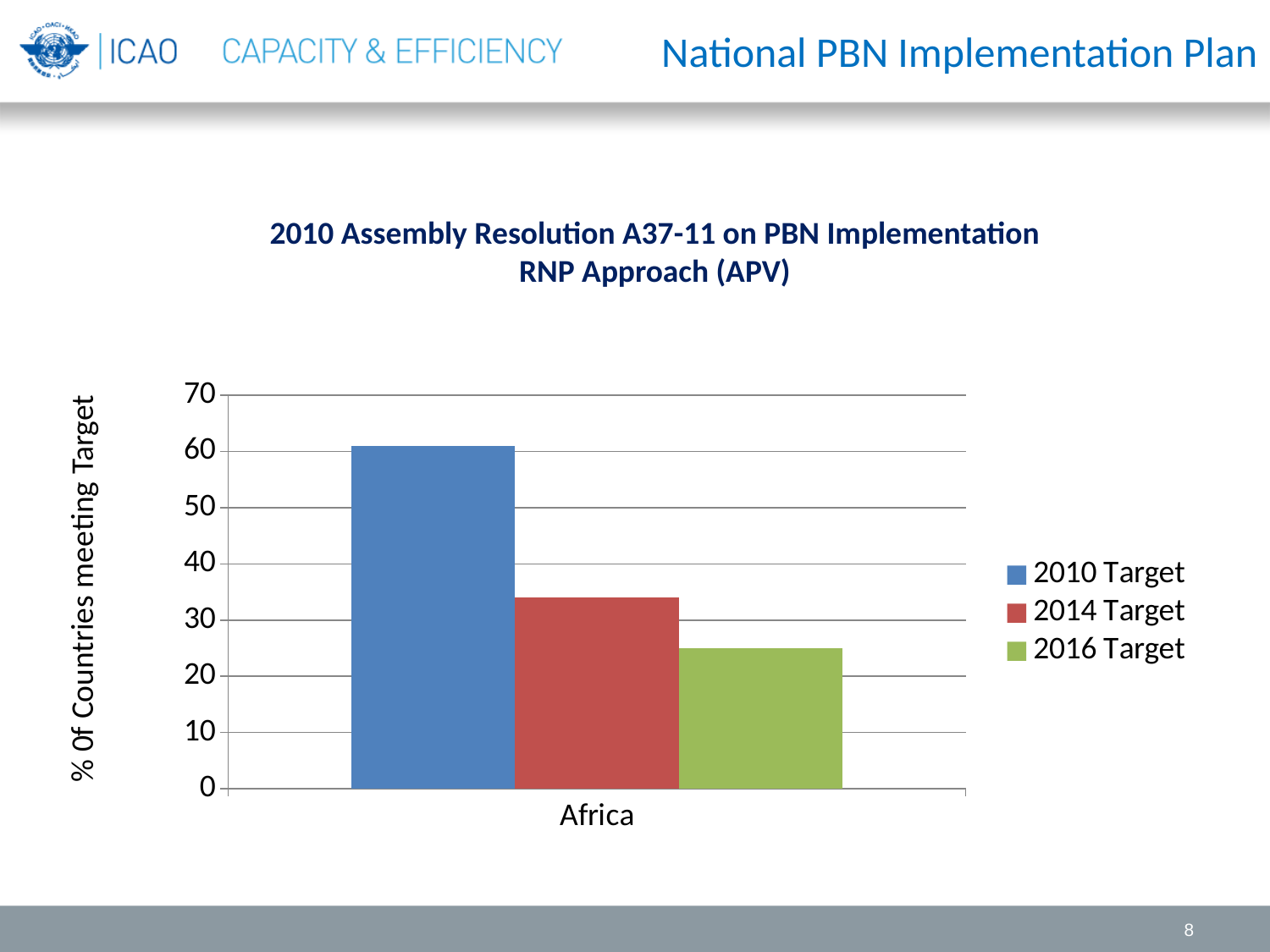
How many series does the chart's legend list? 3 For Africa, which is larger: the 2014 Target or the 2016 Target? 2014 Target Which series has the highest value for Africa? 2010 Target Do the bars for Africa rise or fall going from the 2010 Target to the 2016 Target? fall Is the 2010 Target value for Africa greater or less than 50? greater Which colour represents the 2014 Target in the legend? red Which series has the lowest value for Africa? 2016 Target How many categories are shown on the x axis of the chart? 1 Is the 2014 Target value for Africa greater or less than 40? less Is the 2016 Target value for Africa greater or less than 20? greater What is the label on the vertical axis of the chart? % 0f Countries meeting Target What kind of chart is shown on the slide? bar chart